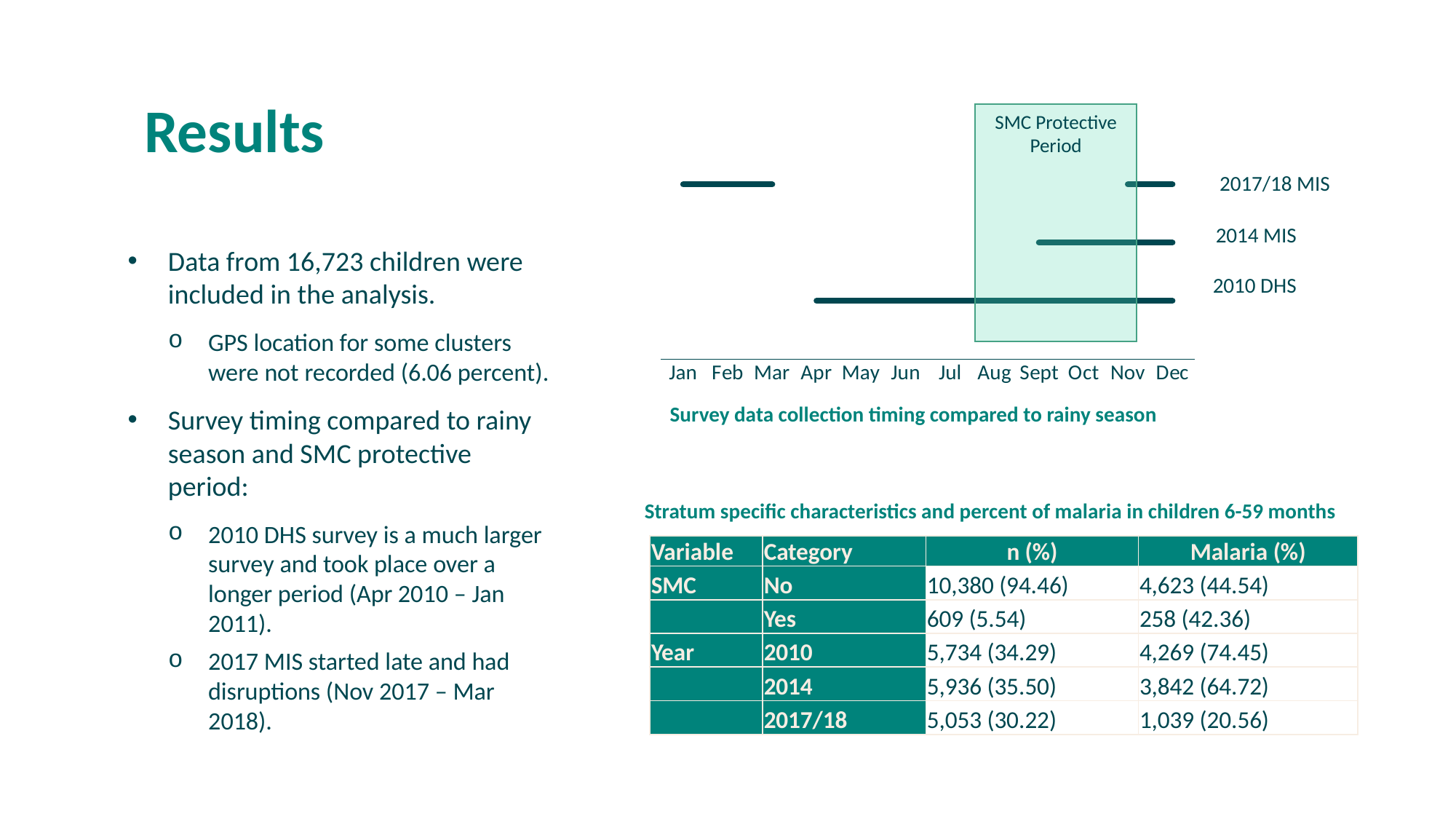
In the survey timing chart, which survey's collection period spans the entire SMC Protective Period? 2010 DHS What is the title of the timeline chart on the slide? Survey data collection timing compared to rainy season In the survey timing chart, which survey has the longest data collection period? 2010 DHS How many months are labelled along the x axis of the survey timing chart? 12 In the survey timing chart, which survey's data collection is shown as two separate segments? 2017/18 MIS In the survey timing chart, which survey's data collection period is longer: 2010 DHS or 2014 MIS? 2010 DHS In the survey timing chart, which survey has the shortest data collection period? 2014 MIS What label is given to the shaded region in the survey timing chart? SMC Protective Period How many surveys are shown as bars in the survey timing chart? 3